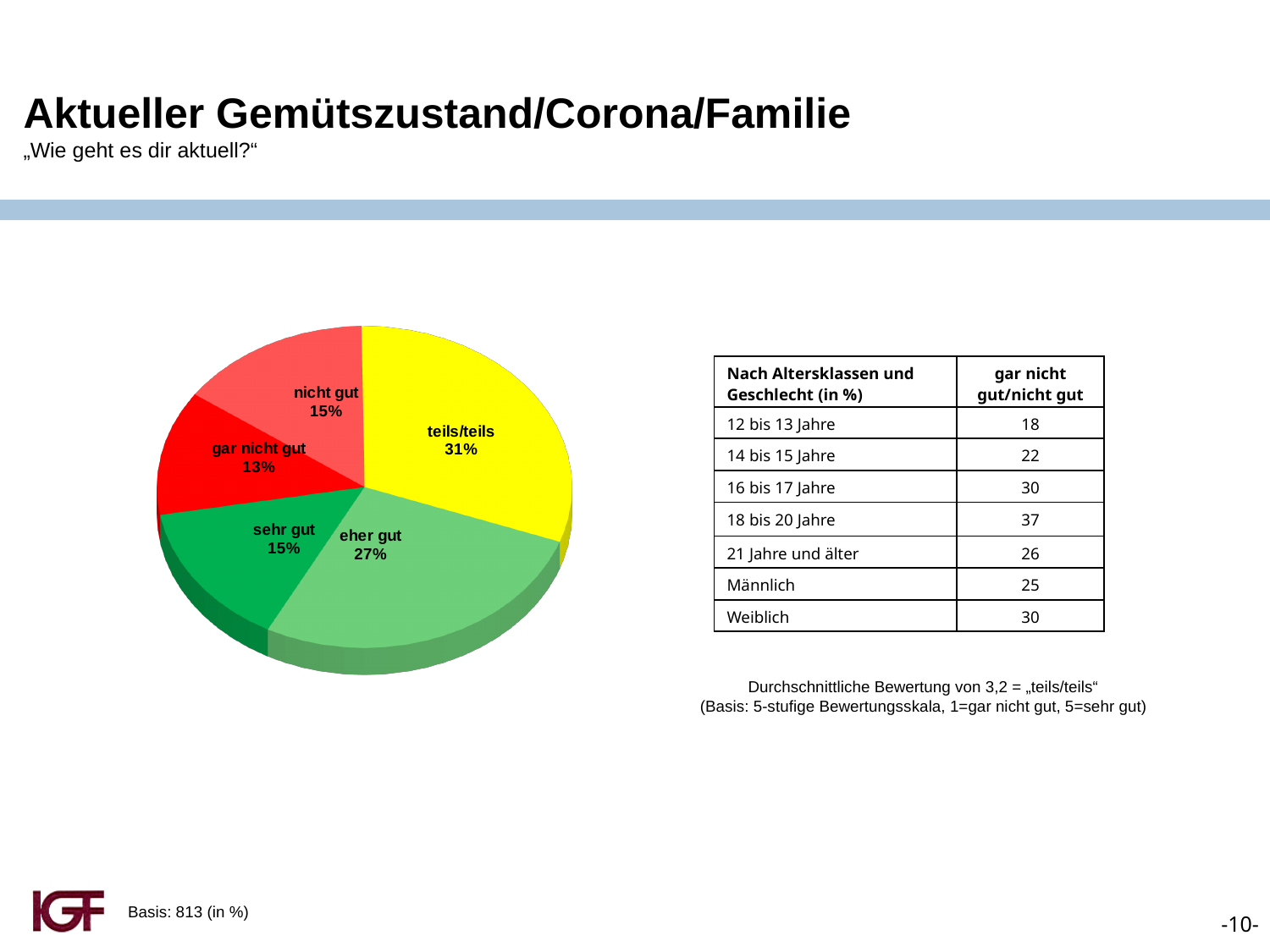
What is the value shown for "gar nicht gut" in the pie chart? 13% What is the difference in percentage points between "teils/teils" and "eher gut" in the pie chart? 4 How many slices does the pie chart have? 5 What is the combined percentage of "sehr gut" and "eher gut" in the pie chart? 42% What share of the pie chart does "eher gut" account for? 27% What colour is the "teils/teils" slice in the pie chart? yellow Which category has the largest slice in the pie chart? teils/teils What percentage is shown for "sehr gut" in the pie chart? 15% Which category has the smallest slice in the pie chart? gar nicht gut What type of chart is shown on the slide? pie chart Which is larger in the pie chart: "eher gut" or "nicht gut"? eher gut What percentage of the pie chart is labelled "teils/teils"? 31%